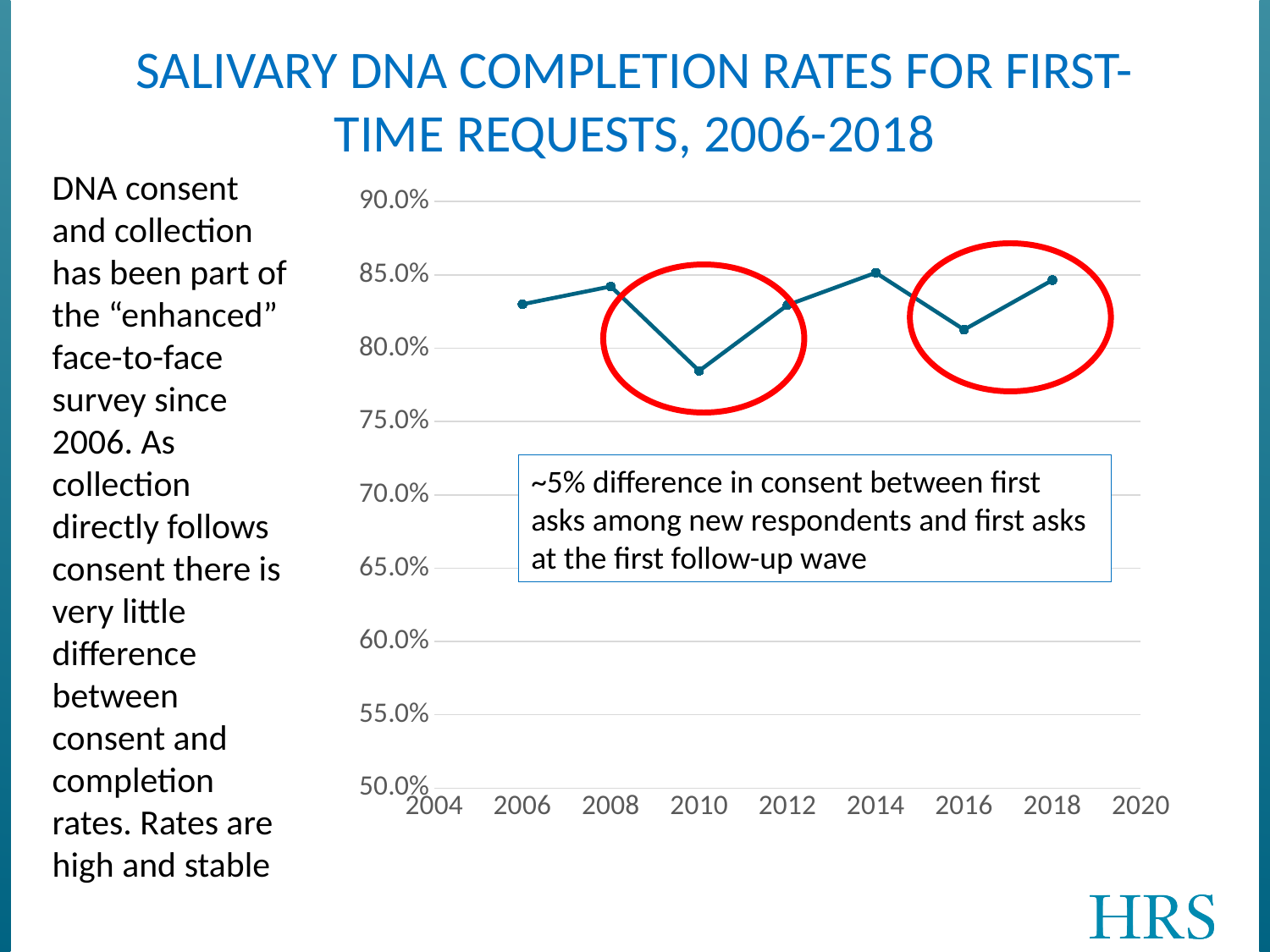
Which is larger, the value for 2008 or the value for 2010? 2008 How many red circles are drawn on the chart? 2 What is the title of the chart on the slide? SALIVARY DNA COMPLETION RATES FOR FIRST-TIME REQUESTS, 2006-2018 Is the value for 2016 greater or less than 80.0%? greater Which year has the lowest completion rate? 2010 Is the value for 2010 greater or less than 75.0%? greater What kind of chart is shown on the slide? line chart Is the value for 2010 greater or less than 80.0%? less Which year has the highest completion rate? 2014 How many data points are plotted on the line? 7 Does the completion rate rise or fall from 2010 to 2014? rise